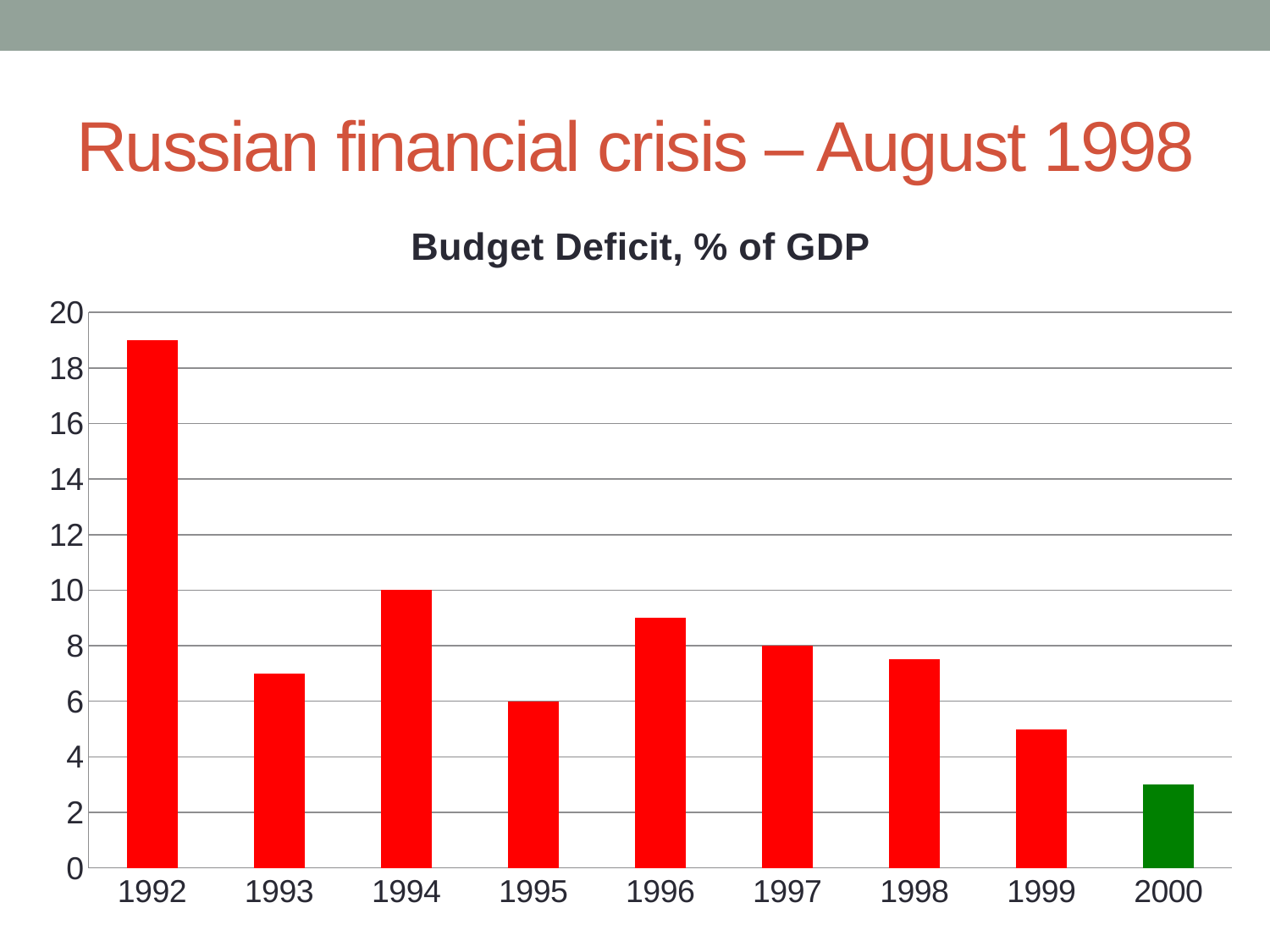
What is the budget deficit as % of GDP in 1997? 8 Which year has the lowest budget deficit? 2000 How many years are shown on the x axis of the chart? 9 What is the title of the chart? Budget Deficit, % of GDP Which year has the highest budget deficit? 1992 What is the difference between the budget deficit in 1994 and in 1995? 4 What is the budget deficit as % of GDP in 1994? 10 What type of chart is shown on the slide? Bar chart Is the value for 1992 greater or less than 18? greater What is the budget deficit as % of GDP in 1995? 6 Which year has a larger budget deficit, 1996 or 1999? 1996 Is the value for 2000 greater or less than 4? less